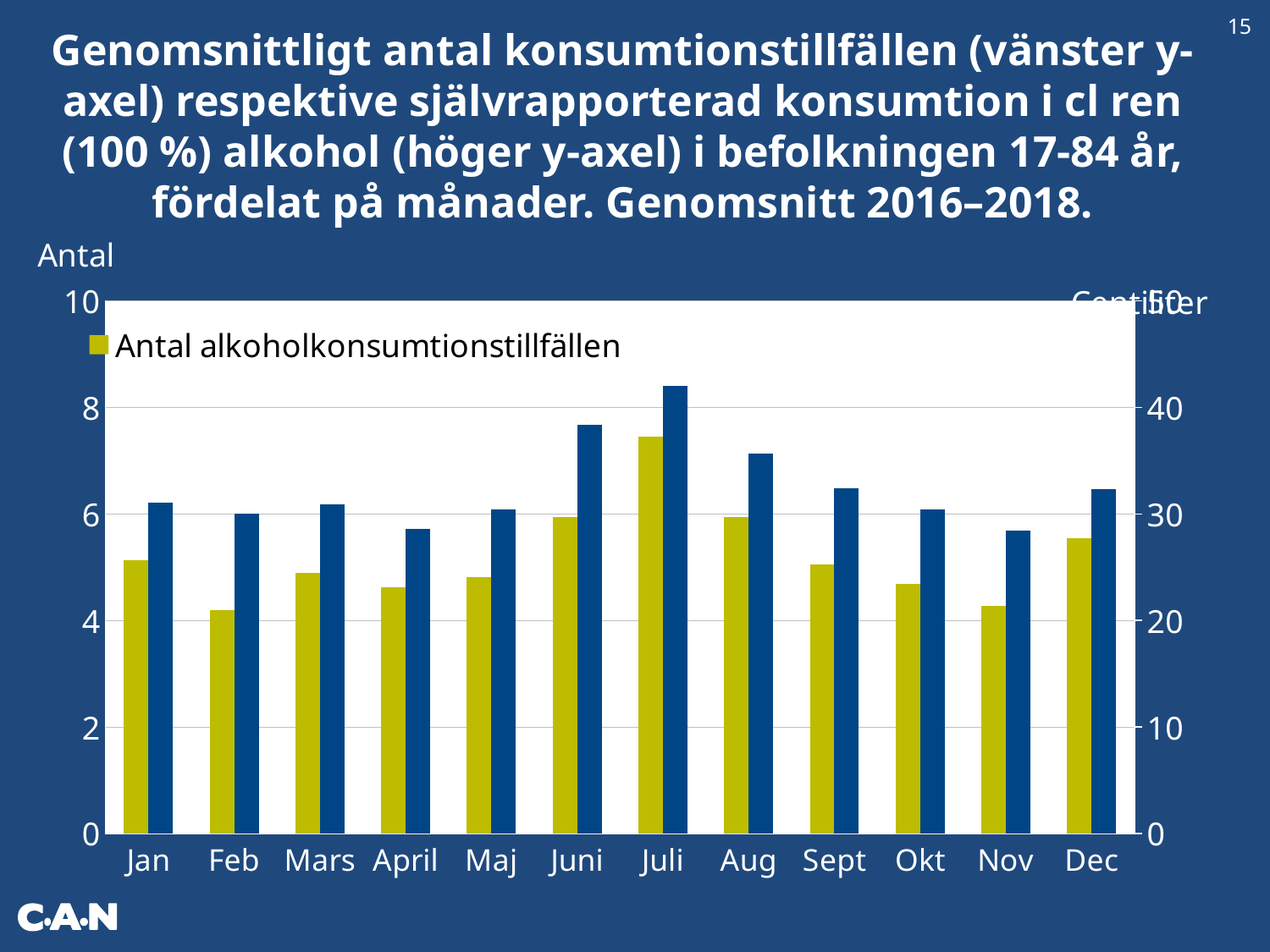
Is the yellow bar (Antal alkoholkonsumtionstillfällen) for Juli greater or less than 6 on the left axis? greater What kind of chart is shown on the slide? bar chart Which month has the highest blue bar? Juli What is the label of the left y axis? Antal Which is larger, the yellow bar for Juli or the yellow bar for Feb? Juli How many series does the legend list? 1 Is the yellow bar (Antal alkoholkonsumtionstillfällen) for Feb greater or less than 5 on the left axis? less How many months are shown along the x axis? 12 Is the blue bar for Juli greater or less than 40 on the right axis? greater Do the yellow bars rise or fall from Juli to Nov? fall Which is larger, the blue bar for Juni or the blue bar for Maj? Juni Which month has the highest yellow bar (Antal alkoholkonsumtionstillfällen)? Juli